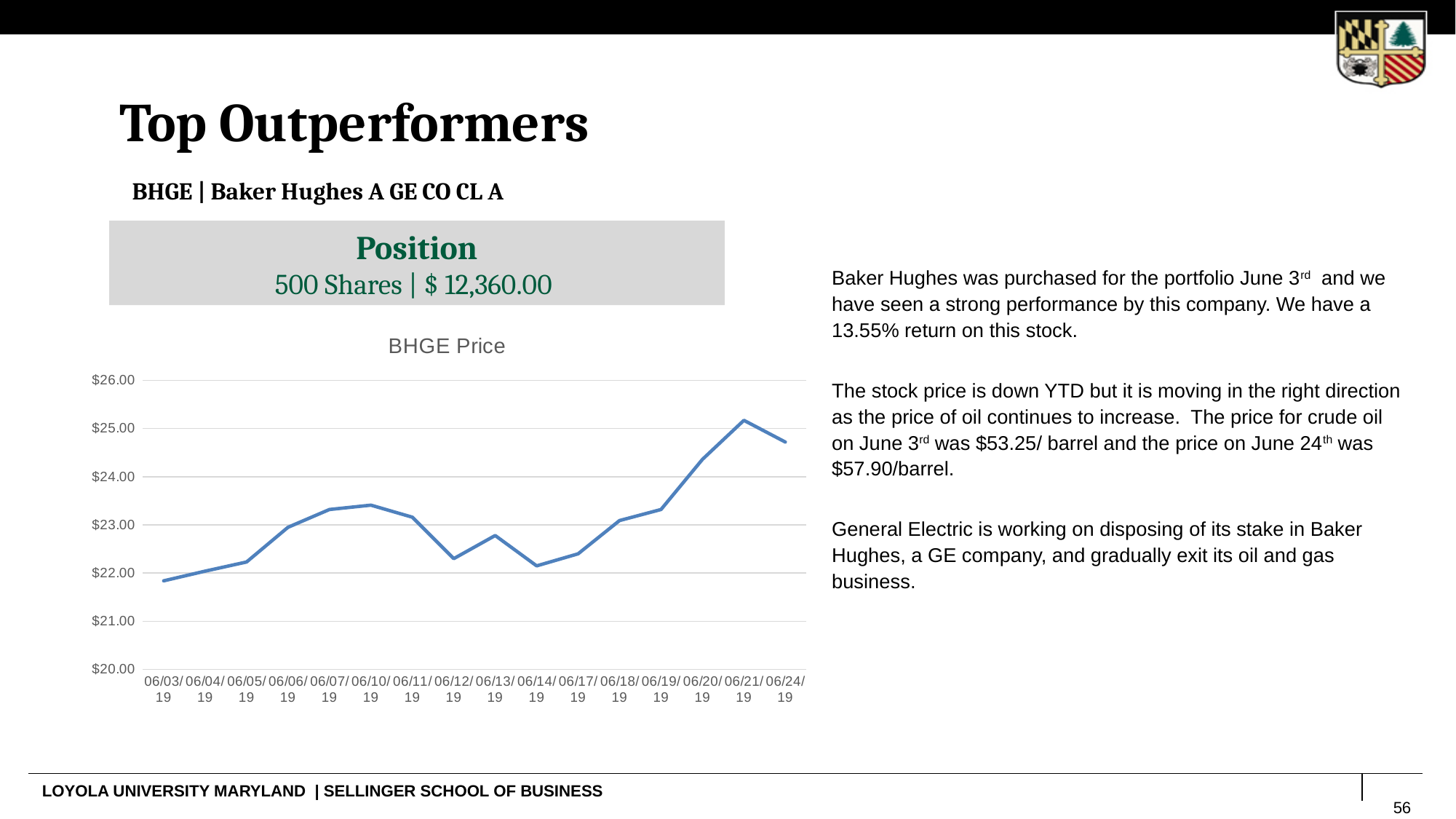
Is the BHGE price on 06/21/19 greater or less than $25.00? greater How many dates are plotted along the x axis of the BHGE Price chart? 16 On which date does the BHGE Price chart reach its highest value? 06/21/19 Which date has a higher BHGE price, 06/12/19 or 06/13/19? 06/13/19 On which date does the BHGE Price chart show its lowest value? 06/03/19 Is the BHGE price on 06/10/19 greater or less than $23.00? greater Overall, does the BHGE price rise or fall from 06/03/19 to 06/24/19? rise What kind of chart is shown on the slide? line chart Is the BHGE price on 06/14/19 greater or less than $23.00? less What is the title of the chart? BHGE Price Which date has a higher BHGE price, 06/21/19 or 06/24/19? 06/21/19